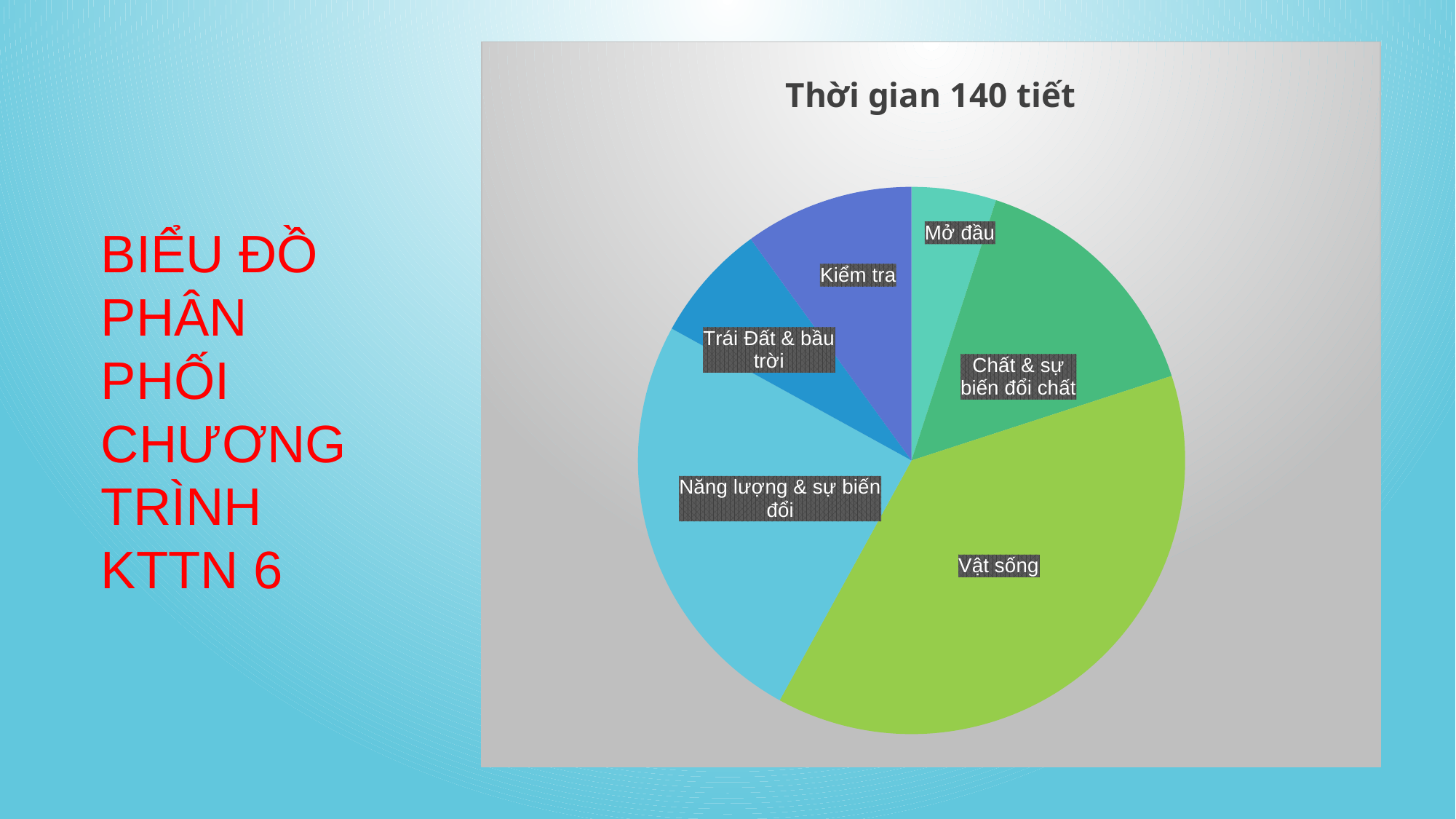
Which category has the largest slice in the pie chart? Vật sống Which slice is larger, Vật sống or Năng lượng & sự biến đổi? Vật sống What kind of chart is shown on the slide? Pie chart How many slices does the pie chart have? 6 What colour is the Vật sống slice? Green Which slice is larger, Chất & sự biến đổi chất or Kiểm tra? Chất & sự biến đổi chất What is the title of the pie chart? Thời gian 140 tiết Which slice is larger, Vật sống or Mở đầu? Vật sống